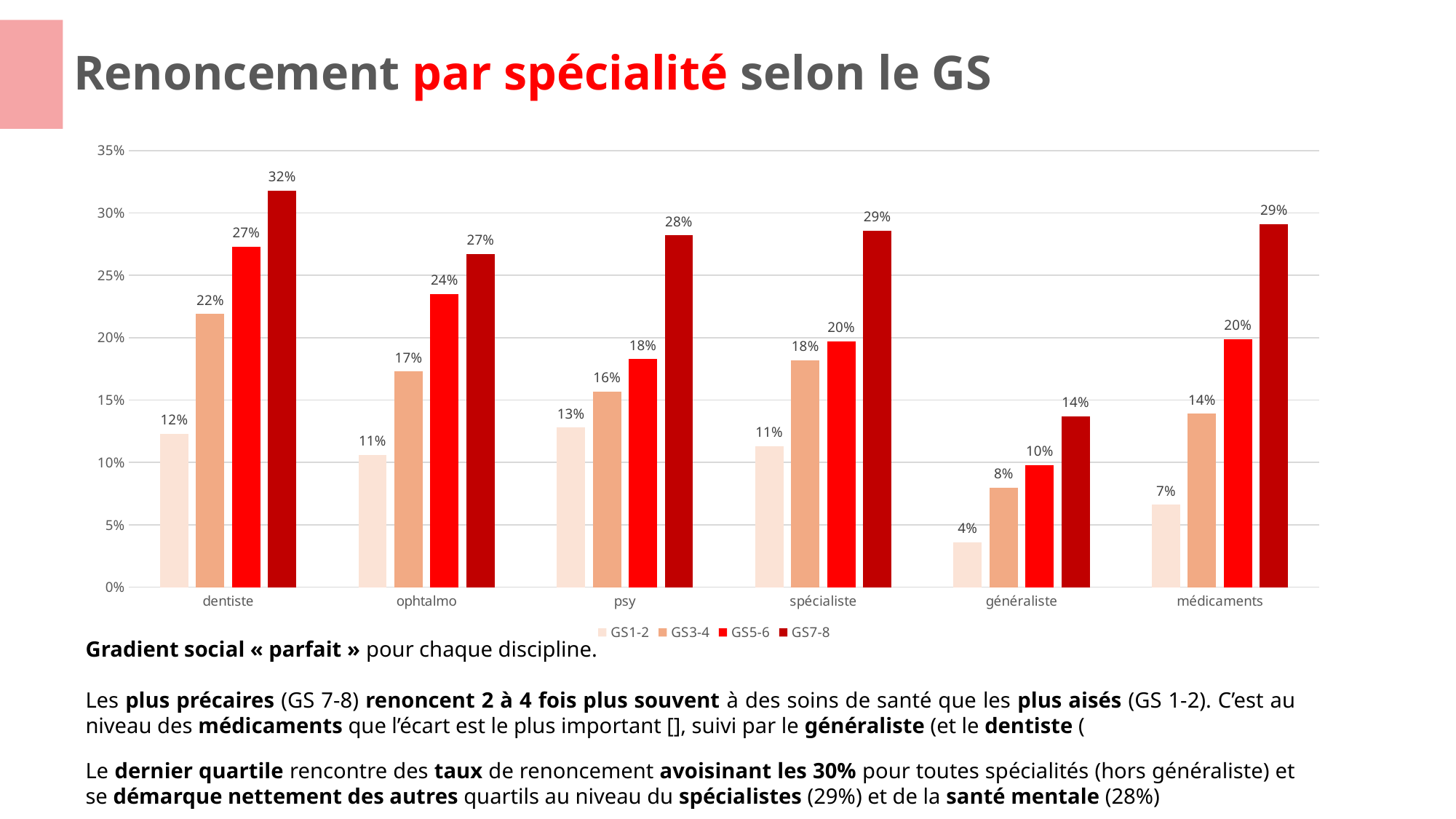
What is the value for GS7-8 in the dentiste category? 32% How many categories are shown on the x axis? 6 What is the difference between the GS7-8 and GS1-2 values for médicaments? 22% What is the value for GS5-6 in the ophtalmo category? 24% How many series does the legend list? 4 What kind of chart is shown on the slide? bar chart Which is larger: the GS3-4 value for dentiste or the GS3-4 value for psy? dentiste What is the value for GS1-2 in the généraliste category? 4% Which category has the lowest GS1-2 value? généraliste What is the title of the slide? Renoncement par spécialité selon le GS What is the value for GS3-4 in the médicaments category? 14% Which category has the highest GS7-8 value? dentiste